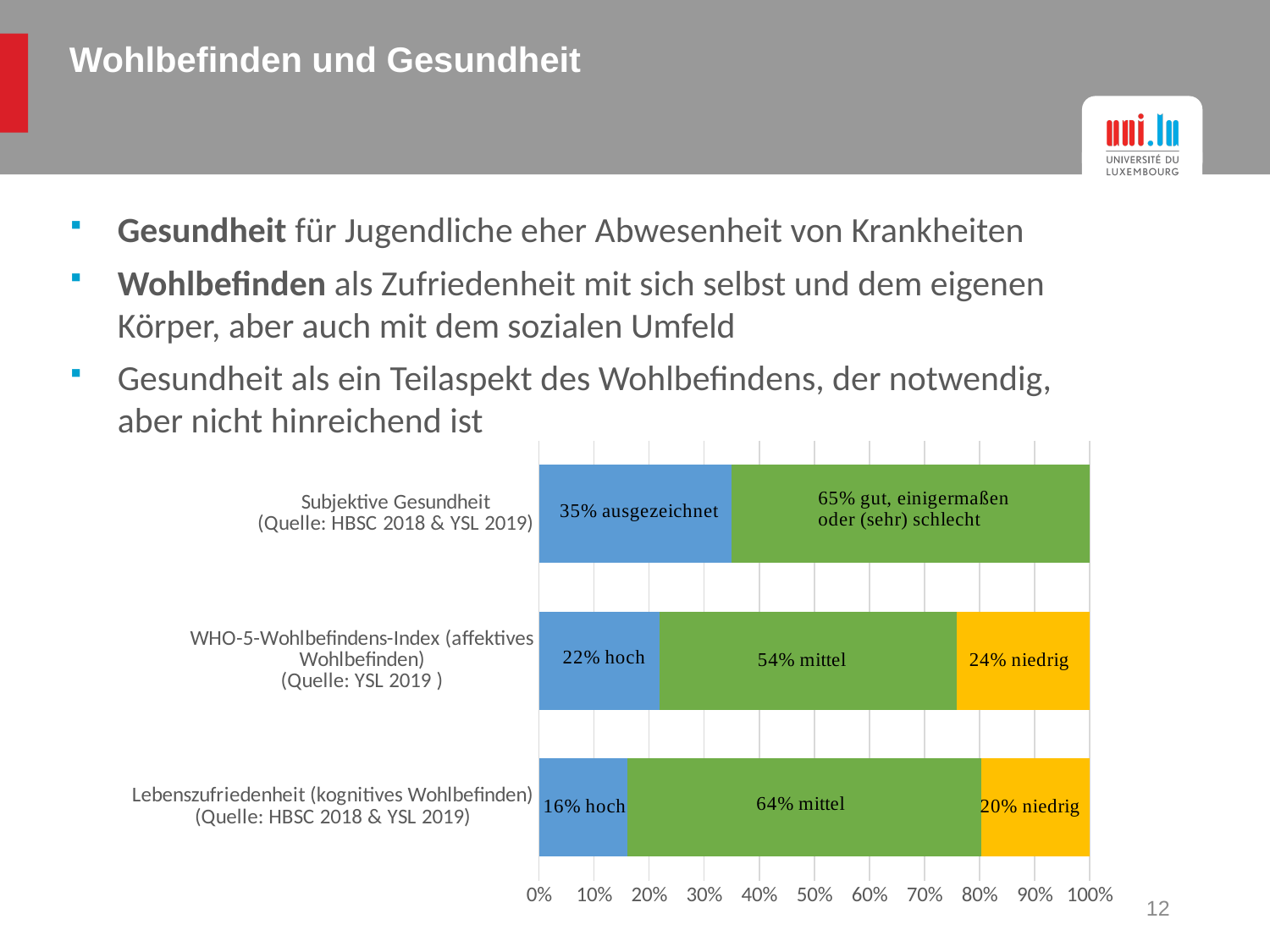
What percentage of the WHO-5-Wohlbefindens-Index bar is labelled "niedrig"? 24% What is the total of the three segments in the WHO-5-Wohlbefindens-Index bar? 100% How many categories (bars) are shown in the chart? 3 What kind of chart is shown on the slide? Stacked bar chart What percentage of the Subjektive Gesundheit bar is labelled "ausgezeichnet"? 35% What colour are the "niedrig" segments in the chart? Yellow Which has the larger "niedrig" share: the WHO-5-Wohlbefindens-Index or Lebenszufriedenheit? WHO-5-Wohlbefindens-Index Which bar has the larger "hoch" share: WHO-5-Wohlbefindens-Index or Lebenszufriedenheit? WHO-5-Wohlbefindens-Index What percentage of the WHO-5-Wohlbefindens-Index bar is labelled "hoch"? 22% What percentage of the Lebenszufriedenheit (kognitives Wohlbefinden) bar is labelled "mittel"? 64% Is the "gut, einigermaßen oder (sehr) schlecht" share of Subjektive Gesundheit greater or less than 60%? greater What is the difference in percentage points between the "mittel" share of Lebenszufriedenheit and the "mittel" share of the WHO-5-Wohlbefindens-Index? 10 percentage points